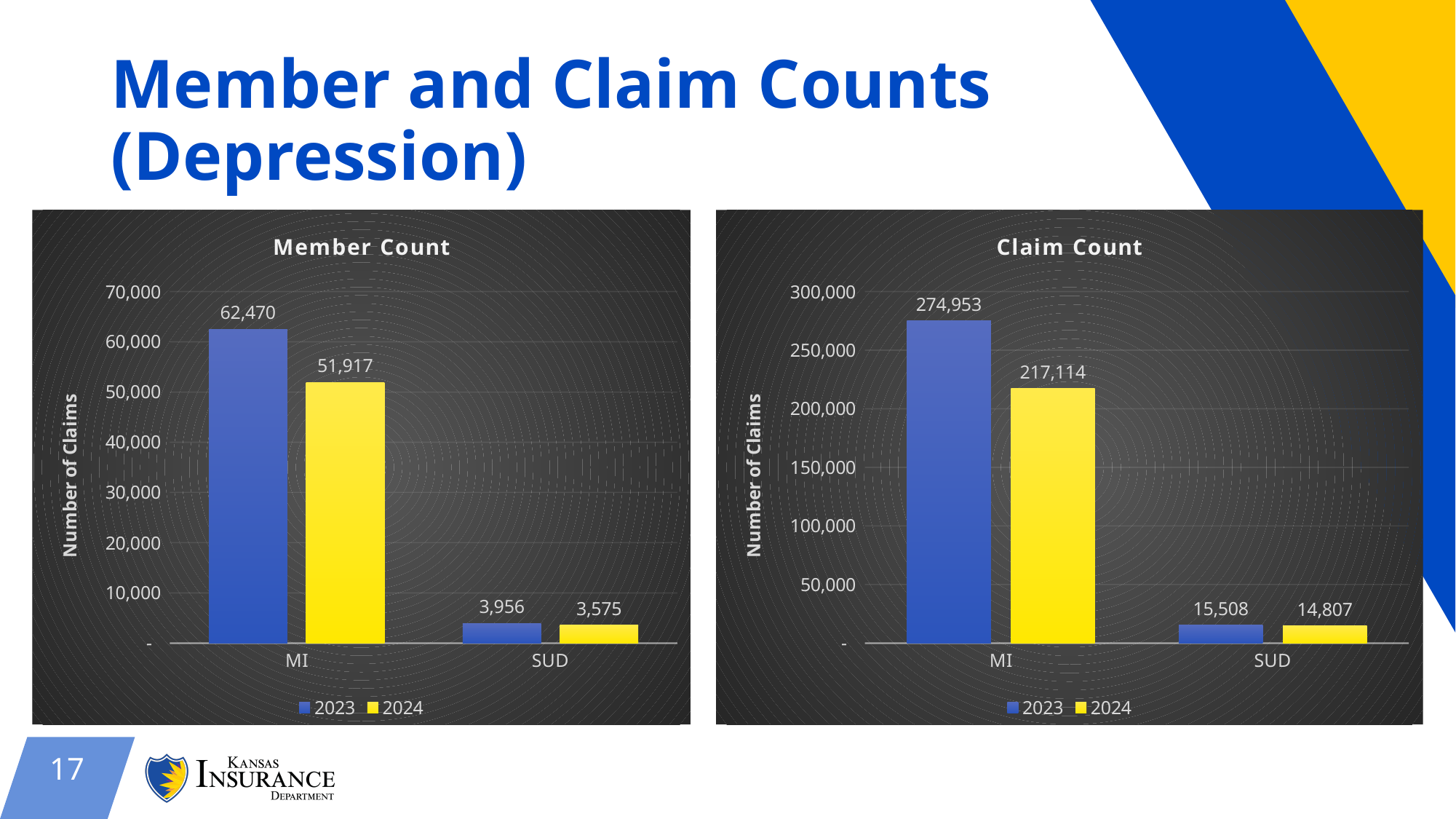
In the Claim Count chart, what is the 2024 value for MI? 217,114 In the Claim Count chart, what is the difference between the 2023 and 2024 values for SUD? 701 In the Claim Count chart, is the 2023 value for MI larger or smaller than the 2024 value for MI? larger In the Claim Count chart, which bar is the highest? MI 2023 In the Member Count chart, what is the 2024 value for SUD? 3,575 What kind of chart is the Member Count chart? bar chart In the Member Count chart, what is the difference between the 2023 and 2024 values for MI? 10,553 How many categories are shown on the x axis of the Claim Count chart? 2 How many series does the legend of the Member Count chart list? 2 In the Claim Count chart, what is the 2023 value for SUD? 15,508 In the Member Count chart, what is the 2023 value for MI? 62,470 In the Member Count chart, which bar is the lowest? SUD 2024